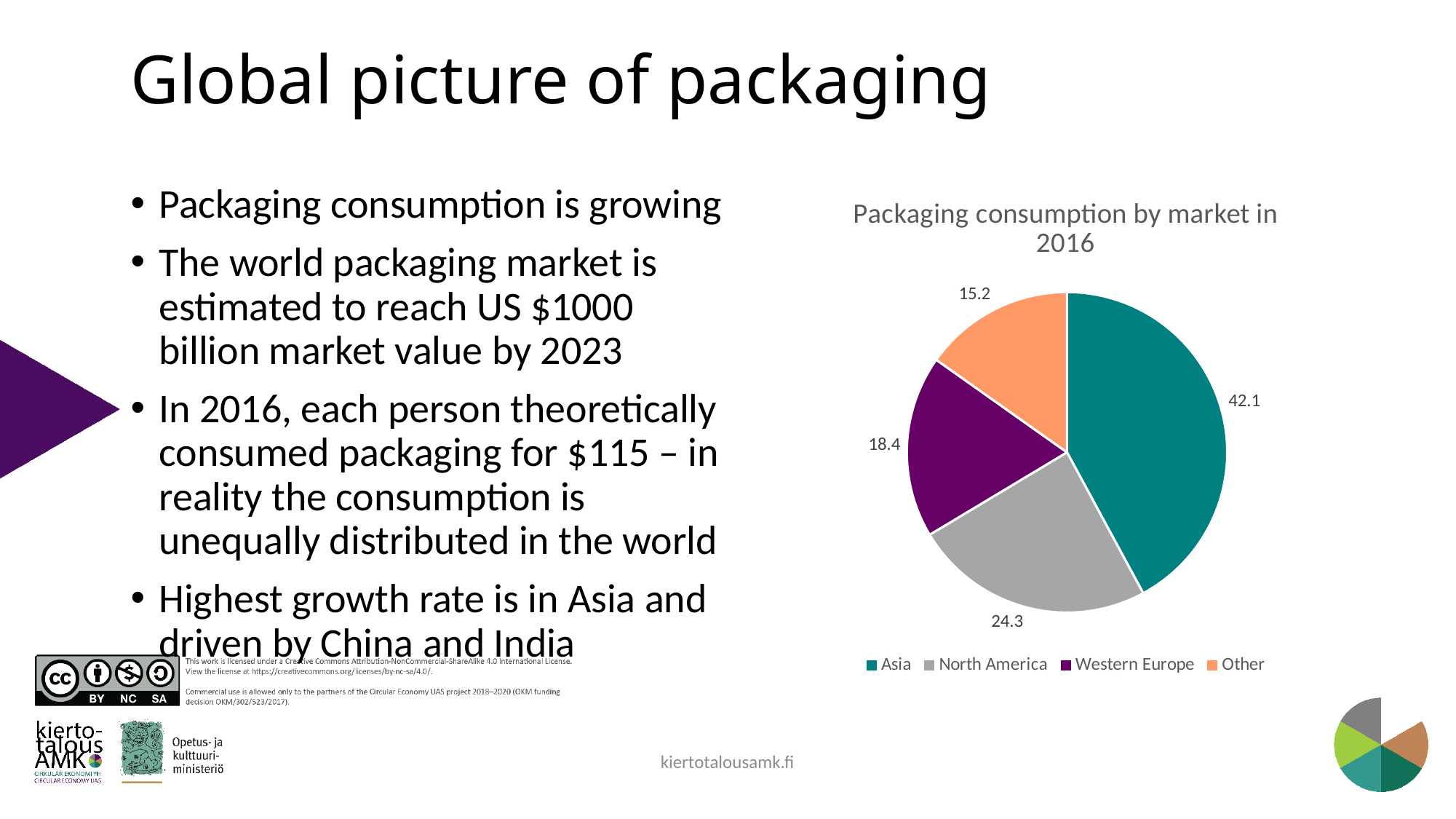
What is the value for North America in the pie chart? 24.3 What is the title of the chart on the slide? Packaging consumption by market in 2016 How many slices does the pie chart have? 4 What is the difference between the values for Asia and North America? 17.8 How many entries does the legend of the pie chart list? 4 Which market has the smallest share of packaging consumption in the pie chart? Other Which market has the largest share of packaging consumption in the pie chart? Asia What is the value for Other in the pie chart? 15.2 What is the value for Western Europe in the pie chart? 18.4 What kind of chart is shown on the slide? Pie chart Which is larger, the value for Western Europe or the value for Other? Western Europe What is the value for Asia in the pie chart? 42.1